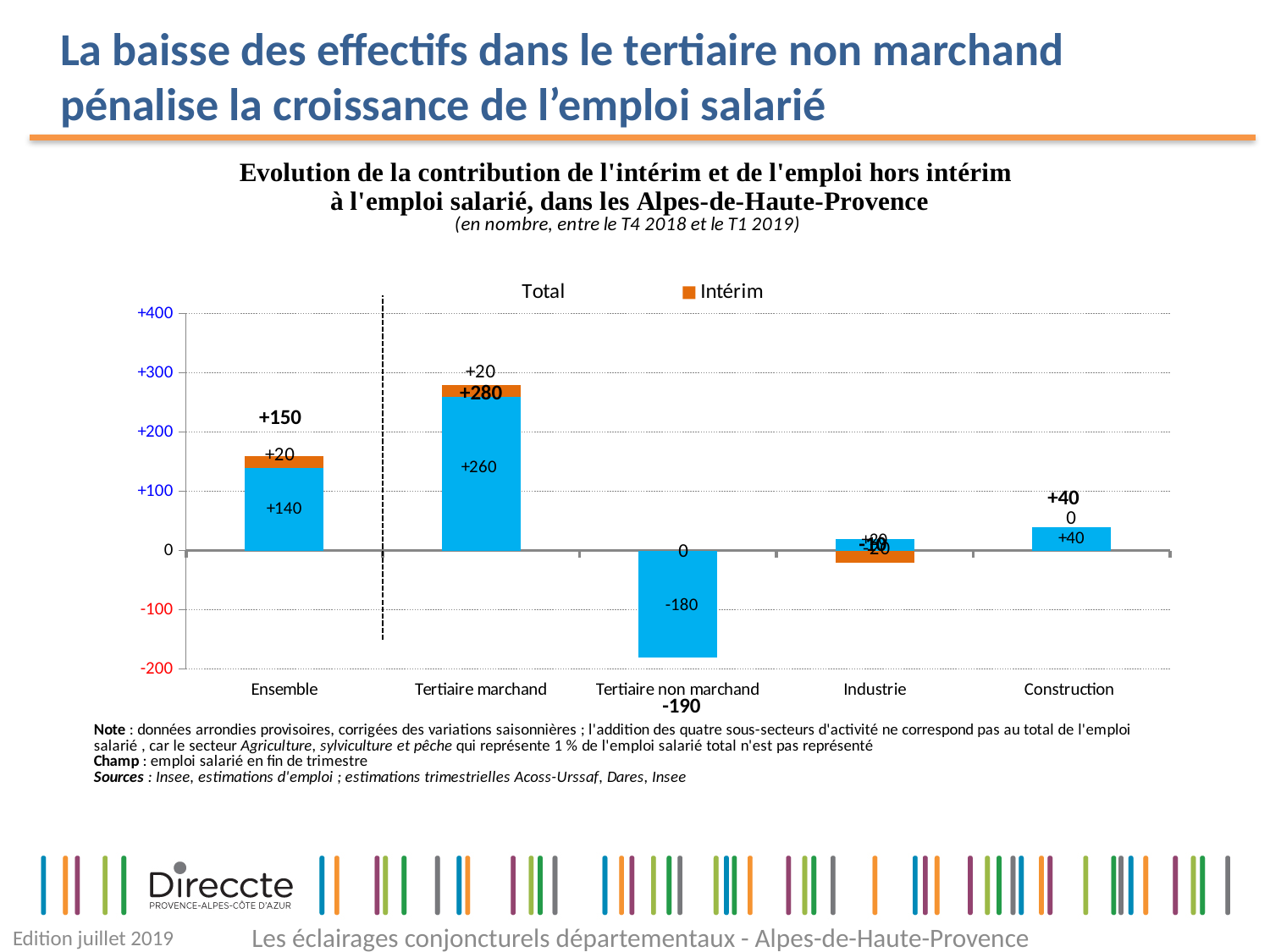
What is the total value labelled for Tertiaire non marchand? -190 How many sectors (categories) are shown on the x axis of the chart? 5 What is the total value labelled for Tertiaire marchand? +280 What is the total value labelled for Construction? +40 How many series does the chart legend list? 2 What kind of chart is shown on the slide? bar chart What is the difference between the total for Tertiaire marchand and the total for Ensemble? 130 Which sector has the lowest total value? Tertiaire non marchand Is the value of the blue bar segment for Tertiaire non marchand greater or less than -100? less What is the value of the blue bar segment for Tertiaire marchand? +260 What is the Intérim value for Ensemble? +20 Which sector has the highest total value? Tertiaire marchand